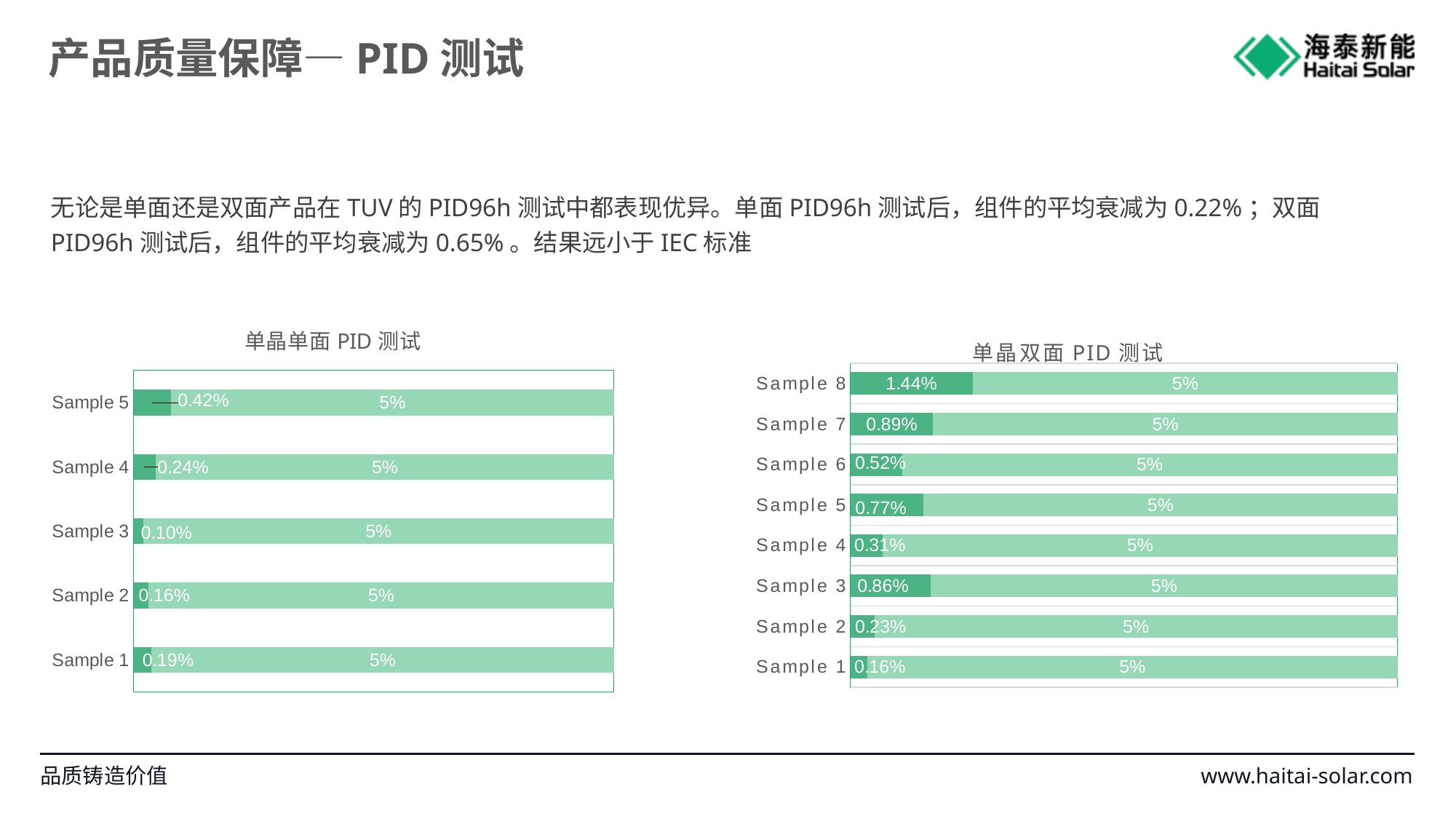
In the 单晶双面 PID 测试 chart, what is the difference between the measured values of Sample 8 and Sample 7? 0.55% In the 单晶单面 PID 测试 chart, which sample has the lowest measured value? Sample 3 In the 单晶双面 PID 测试 chart, what is the measured value for Sample 8? 1.44% In the 单晶单面 PID 测试 chart, how many samples are shown? 5 In the 单晶双面 PID 测试 chart, what is the measured value for Sample 4? 0.31% In the 单晶单面 PID 测试 chart, what is the measured value for Sample 3? 0.10% In the 单晶双面 PID 测试 chart, which sample has the lowest measured value? Sample 1 In the 单晶双面 PID 测试 chart, how many samples are shown? 8 What type of chart is the 单晶双面 PID 测试 chart? Bar chart In the 单晶单面 PID 测试 chart, which sample has the highest measured value? Sample 5 In the 单晶单面 PID 测试 chart, what is the measured value for Sample 5? 0.42% In the 单晶双面 PID 测试 chart, which is larger, the measured value for Sample 3 or Sample 5? Sample 3